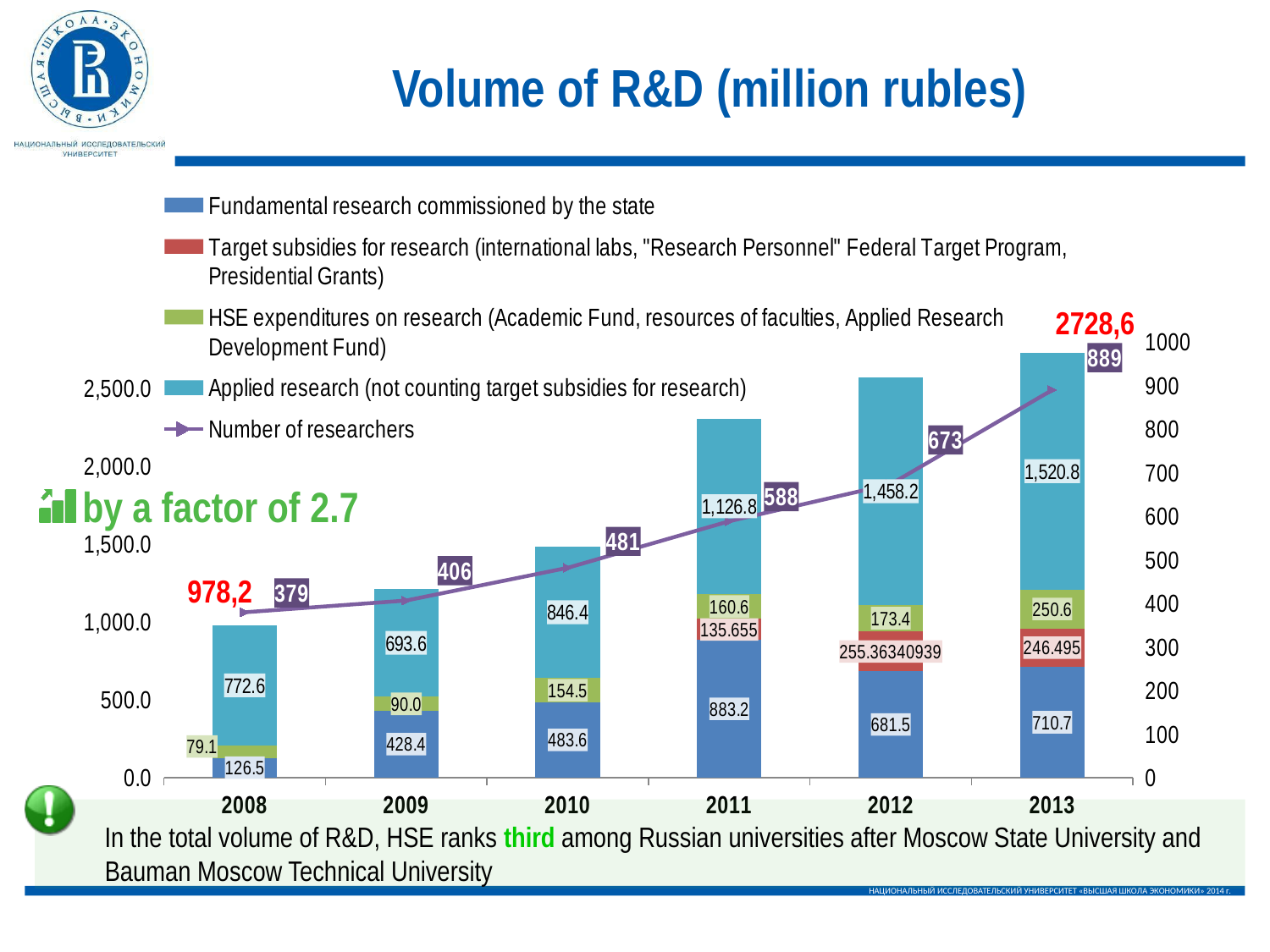
What is the total volume of R&D shown for 2008? 978,2 What is the value of Applied research (not counting target subsidies for research) in 2013? 1,520.8 What is the Number of researchers in 2011? 588 In which year is Fundamental research commissioned by the state lowest? 2008 What is the value of HSE expenditures on research in 2010? 154.5 How many series does the legend list? 5 By how much did the Number of researchers increase from 2008 to 2013? 510 How many years are shown on the x axis? 6 What is the difference between Applied research in 2013 and in 2012? 62.6 Which year has the larger value for Fundamental research commissioned by the state, 2011 or 2012? 2011 In which year is the Number of researchers highest? 2013 What is the value of Fundamental research commissioned by the state in 2009? 428.4